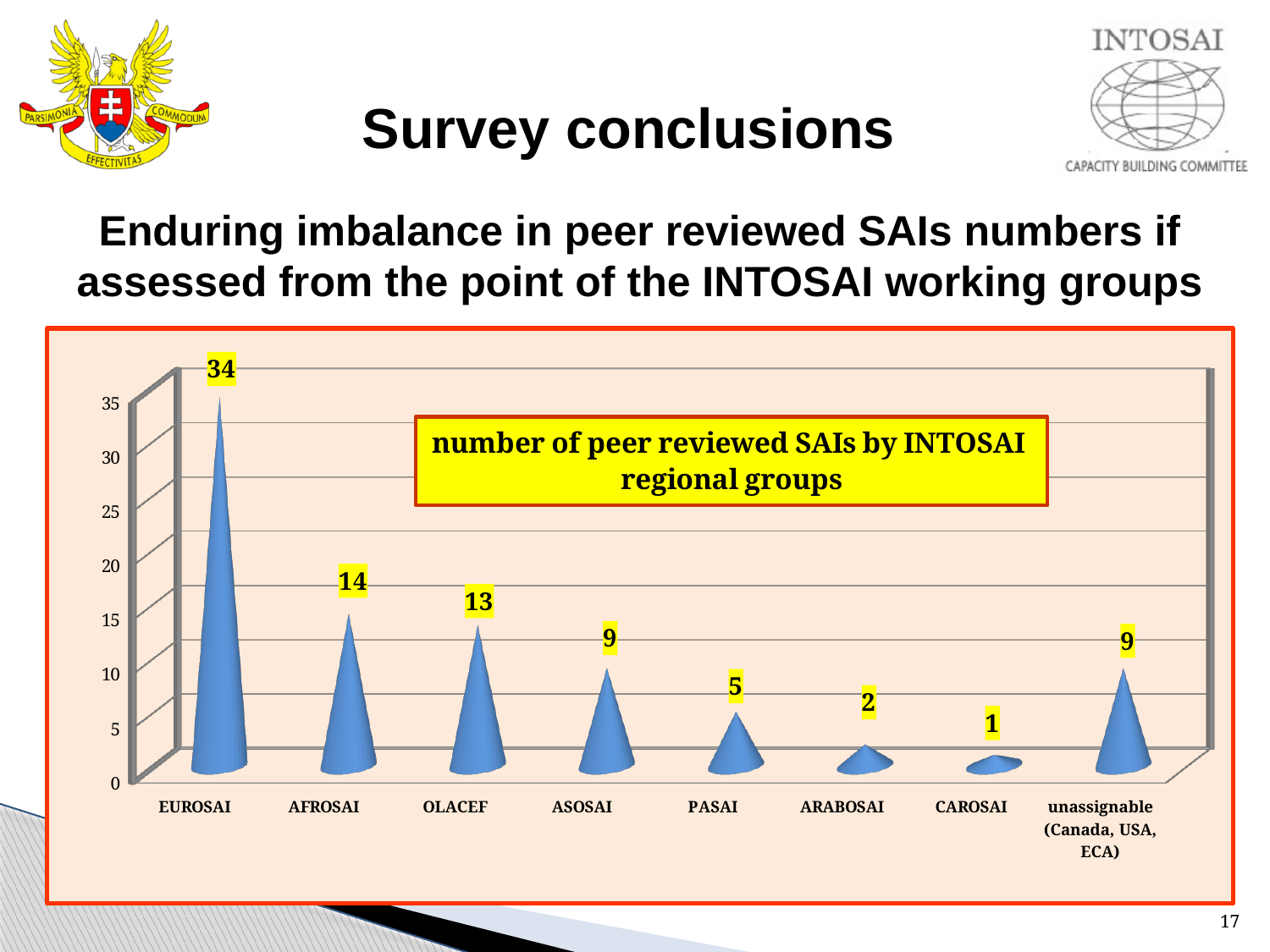
What is the number of peer reviewed SAIs for OLACEF? 13 What is the number of peer reviewed SAIs for PASAI? 5 What is the title shown in the yellow box on the chart? number of peer reviewed SAIs by INTOSAI regional groups Is the value for ASOSAI greater or less than 10? less What is the value for the unassignable (Canada, USA, ECA) category? 9 Which regional group has the lowest number of peer reviewed SAIs? CAROSAI What is the difference between the values for EUROSAI and AFROSAI? 20 What kind of chart is shown on the slide? bar chart Which regional group has the highest number of peer reviewed SAIs? EUROSAI What is the number of peer reviewed SAIs for EUROSAI? 34 How many categories are shown on the x axis of the chart? 8 Which has a larger value, AFROSAI or OLACEF? AFROSAI